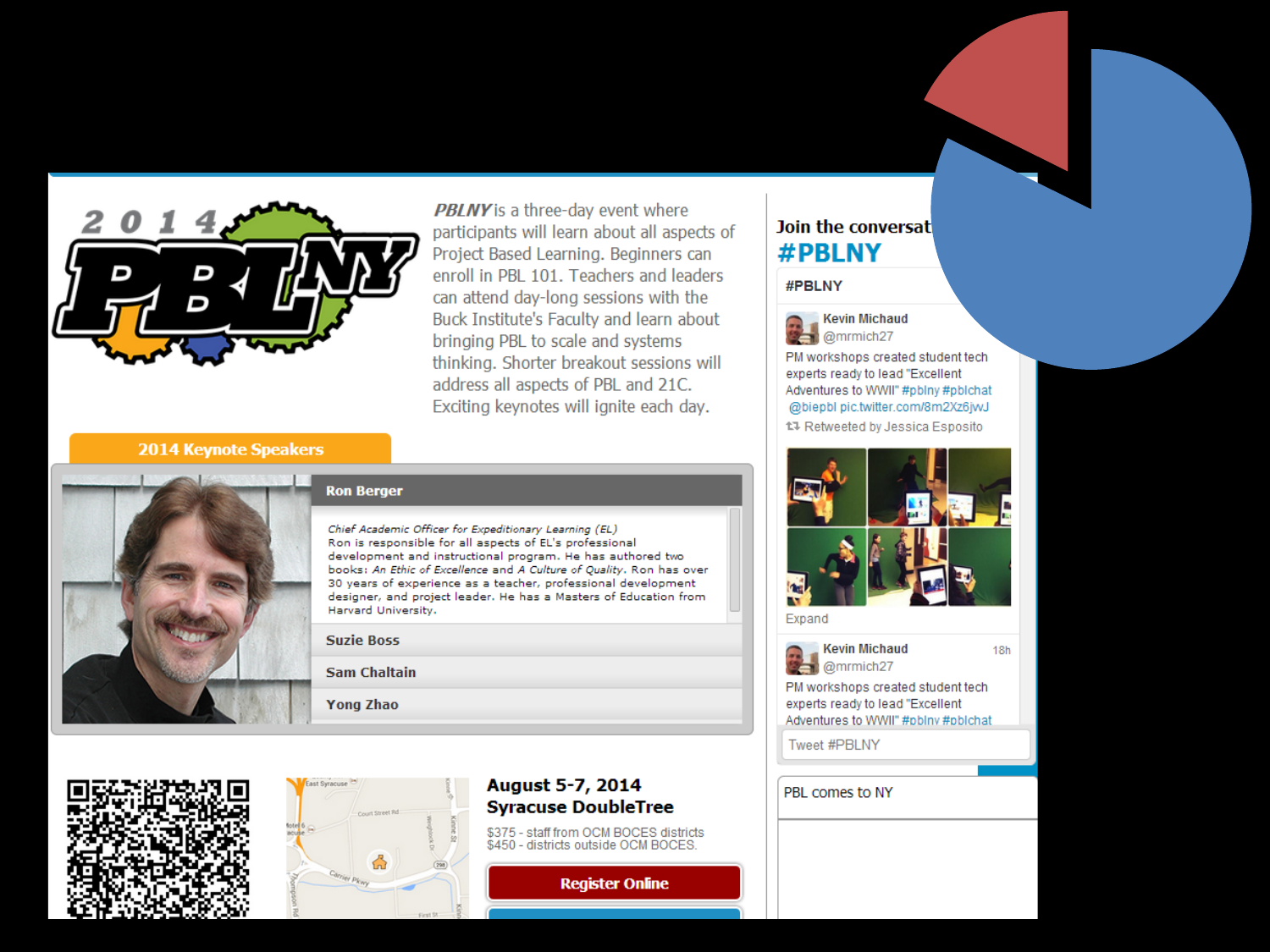
Which colour slice is the largest in the pie chart? blue Which slice of the pie chart is larger, the blue one or the red one? blue What kind of chart is shown in the top right corner of the slide? pie chart Which slice of the pie chart is pulled out (exploded) from the rest? the red slice Which colour slice is the smallest in the pie chart? red Does the pie chart display a legend? No How many slices does the pie chart have? 2 Is the red slice of the pie chart more or less than half of the pie? less